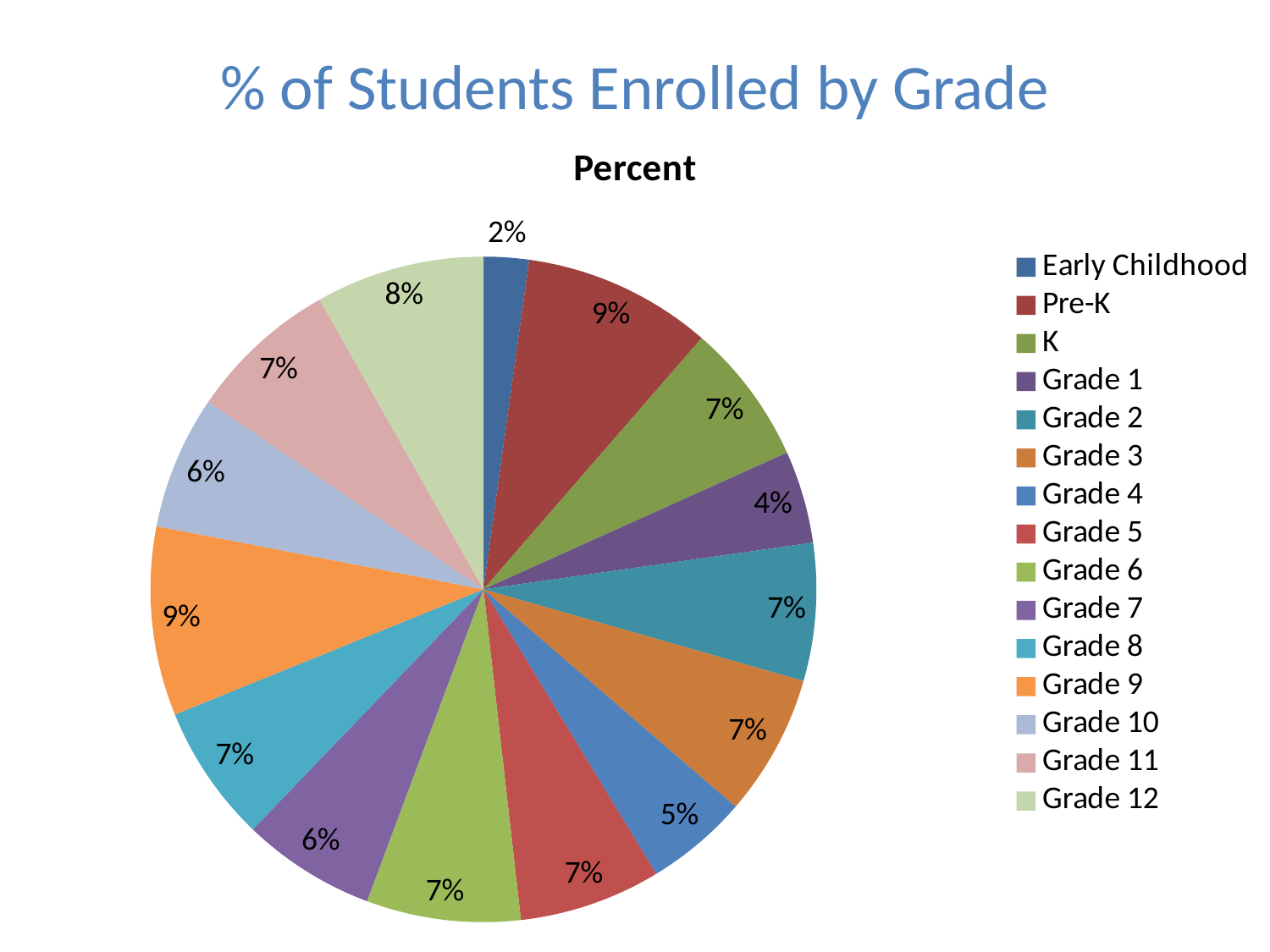
What percentage of students are enrolled in Grade 4? 5% What is the difference in percentage points between Grade 12 and Early Childhood? 6 What type of chart is shown on the slide? Pie chart Which has a larger share of students, Grade 7 or Grade 12? Grade 12 What is the difference in percentage points between Grade 9 and Grade 10? 3 What percentage of students are enrolled in Grade 12? 8% How many grade categories are shown in the pie chart? 15 What is the title of the slide? % of Students Enrolled by Grade What percentage of students are enrolled in Pre-K? 9% What percentage of students are enrolled in Grade 1? 4% What percentage of students are enrolled in Early Childhood? 2% Which grade category has the smallest share of enrolled students? Early Childhood